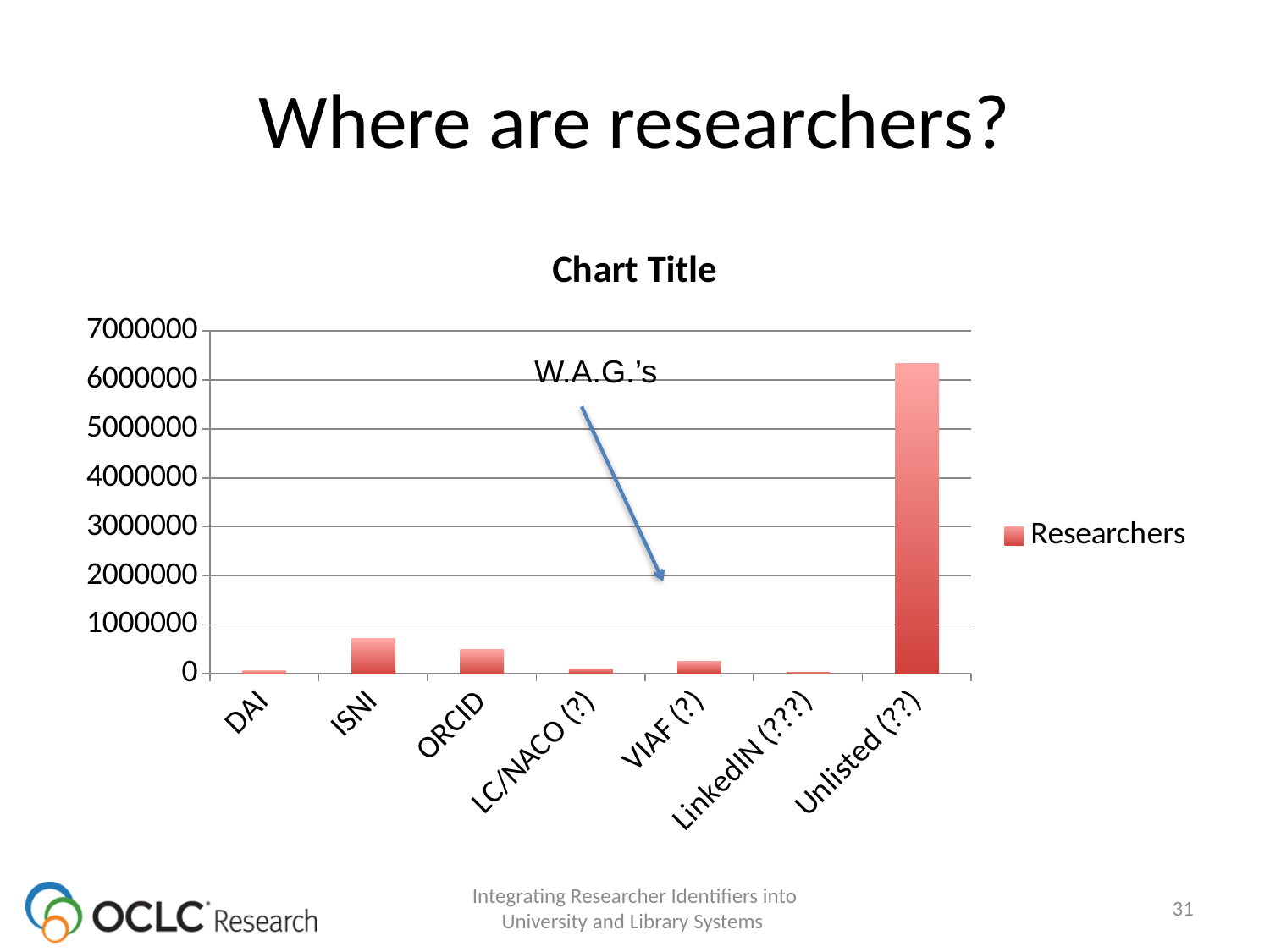
Which has a larger value, VIAF (?) or Unlisted (??)? Unlisted (??) Is the value for ISNI greater or less than 1000000? less How many categories are shown on the x axis of the chart? 7 Is the value for Unlisted (??) greater or less than 6000000? greater Which has a larger value, ISNI or ORCID? ISNI Which category has the highest value in the chart? Unlisted (??) What is the title printed above the chart? Chart Title How many series does the chart legend list? 1 What kind of chart is shown on the slide? bar chart Is the value for ORCID greater or less than 1000000? less What is the name of the series shown in the chart legend? Researchers Which has a larger value, ORCID or LC/NACO (?)? ORCID